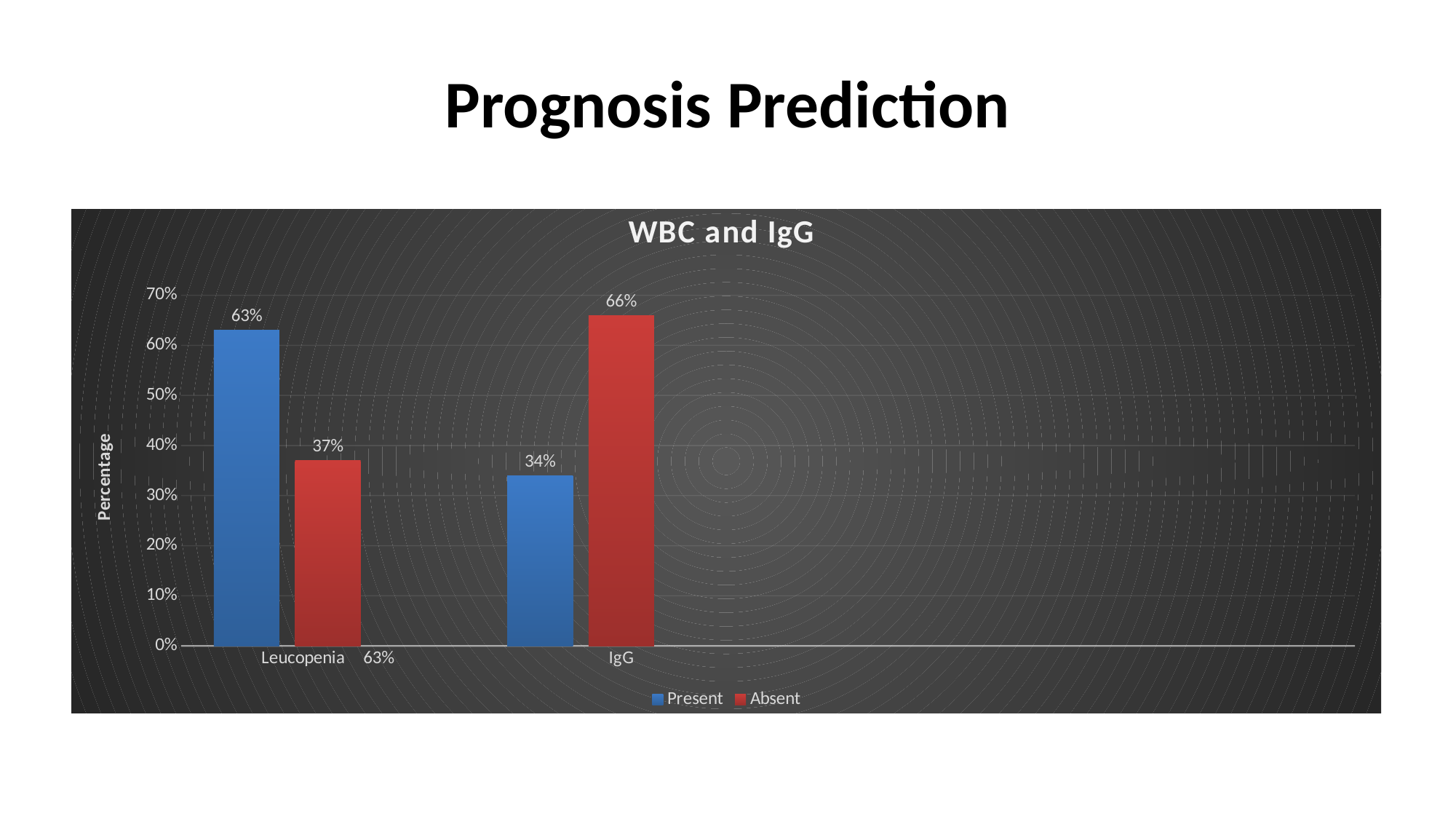
What is the title of the chart? WBC and IgG What is the value for Absent in the Leucopenia category? 37% What is the difference between the Present and Absent values for Leucopenia? 26% Which is larger for IgG, Present or Absent? Absent What kind of chart is shown on the slide? Bar chart Which bar has the highest value on the chart? Absent for IgG How many series does the legend list? 2 What is the value for Present in the IgG category? 34% How many categories are shown on the x axis? 2 What is the value for Present in the Leucopenia category? 63% What is the value for Absent in the IgG category? 66% Which bar has the lowest value on the chart? Present for IgG